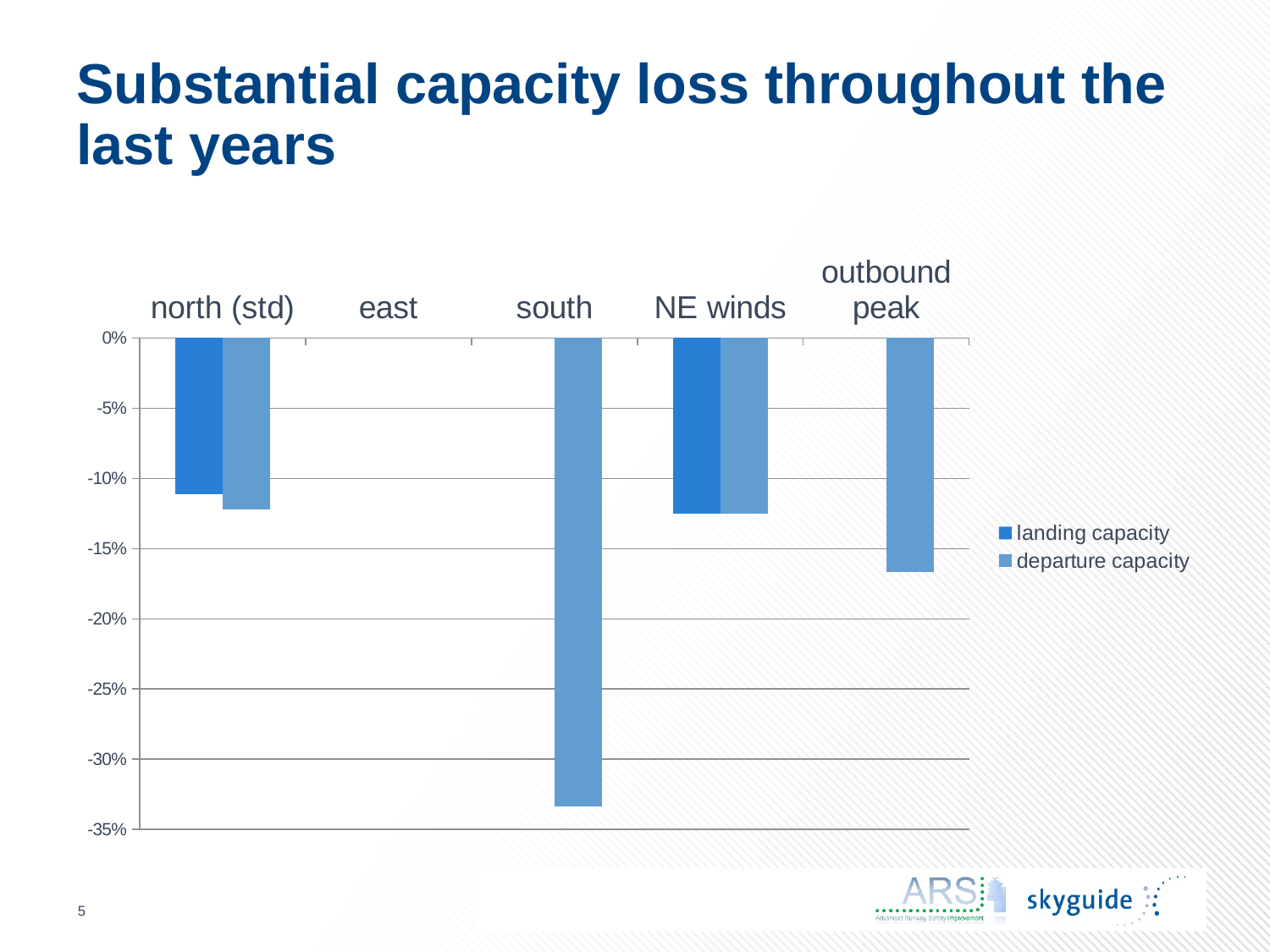
Is the departure capacity value for south greater or less than -30%? less Which is larger, the departure capacity value for north (std) or for outbound peak? north (std) Is the departure capacity value for NE winds greater or less than -10%? less Which category shows no bars at all in the chart? east Is the departure capacity value for outbound peak greater or less than -15%? less How many series does the chart's legend list? 2 Which category has the lowest departure capacity value in the chart? south How many categories are shown on the x axis of the chart? 5 What kind of chart is shown on the slide? bar chart Which series are listed in the chart's legend? landing capacity, departure capacity Which is larger, the departure capacity value for NE winds or for south? NE winds